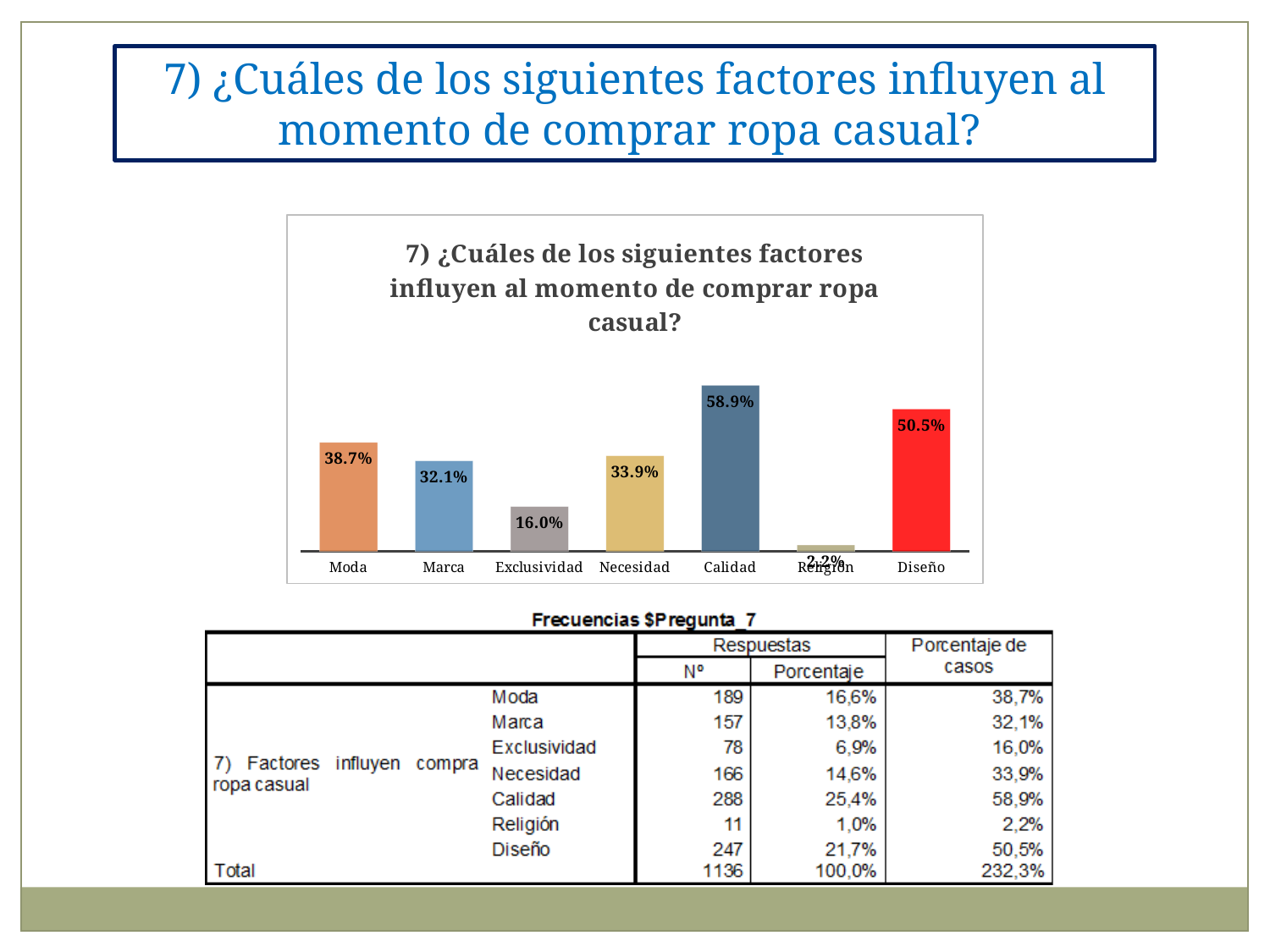
What colour is the bar for Diseño in the chart? Red What is the value for Exclusividad in the bar chart? 16.0% How many categories are shown in the bar chart? 7 Which category has the highest value in the bar chart? Calidad Which is larger in the bar chart, the value for Moda or the value for Necesidad? Moda Which category has the lowest value in the bar chart? Religión What is the difference between the values for Calidad and Diseño in the bar chart? 8.4% What is the value for Necesidad in the bar chart? 33.9% What is the value for Calidad in the bar chart? 58.9% What is the value for Diseño in the bar chart? 50.5% What kind of chart is shown on the slide? Bar chart What is the difference between the values for Moda and Marca in the bar chart? 6.6%